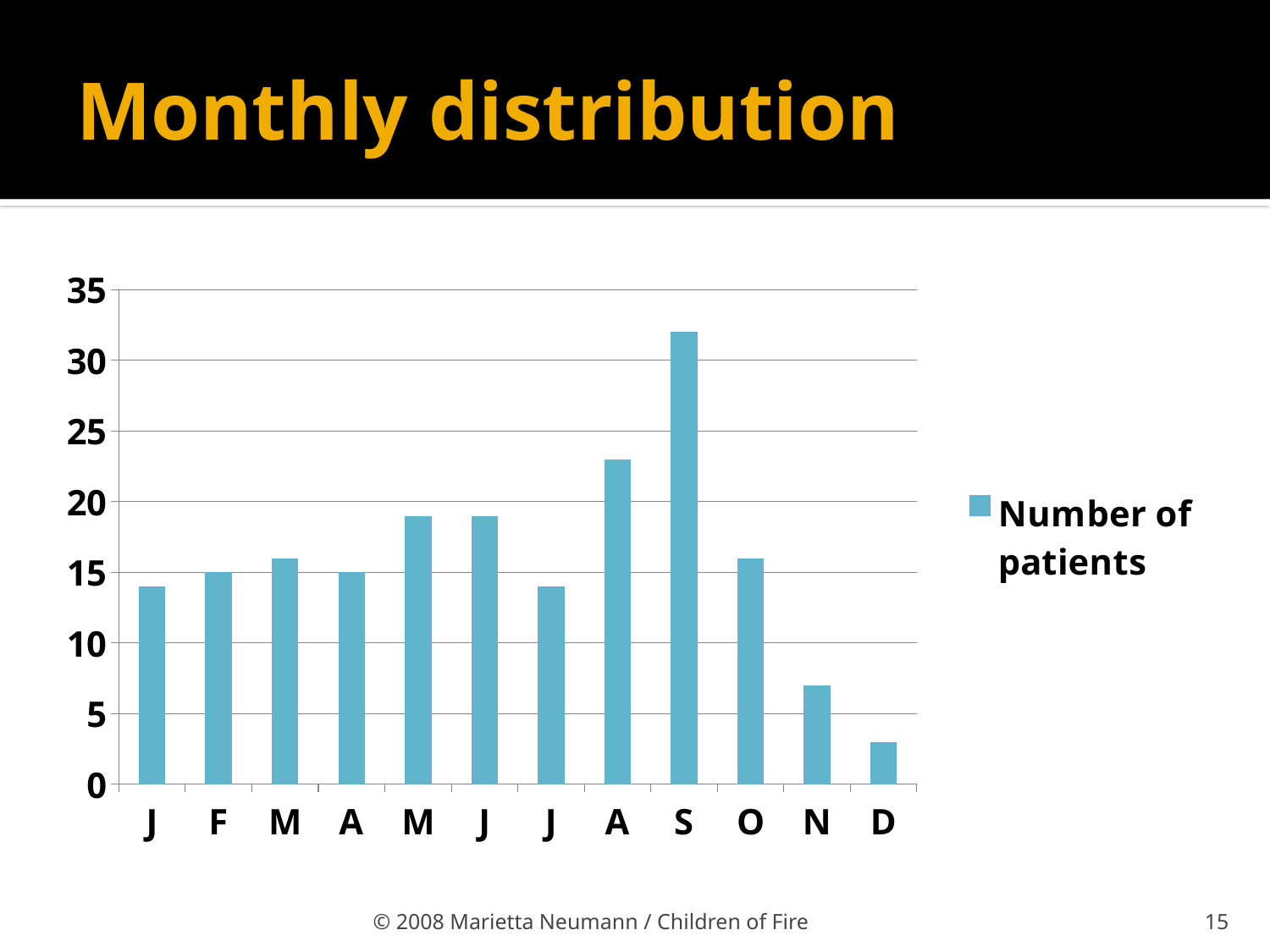
Do the values rise or fall from S through D? fall Is the value for the eighth bar (A, August) greater or less than 20? greater Which month has the highest number of patients? S How many series does the legend list? 1 How many months (bars) are plotted on the chart? 12 Which is larger, the value for S or the value for the eighth bar (A, August)? S What is the legend entry for the series shown? Number of patients Is the value for S greater or less than 30? greater What kind of chart is shown on the slide? bar chart Is the value for D greater or less than 5? less Which month has the lowest number of patients? D